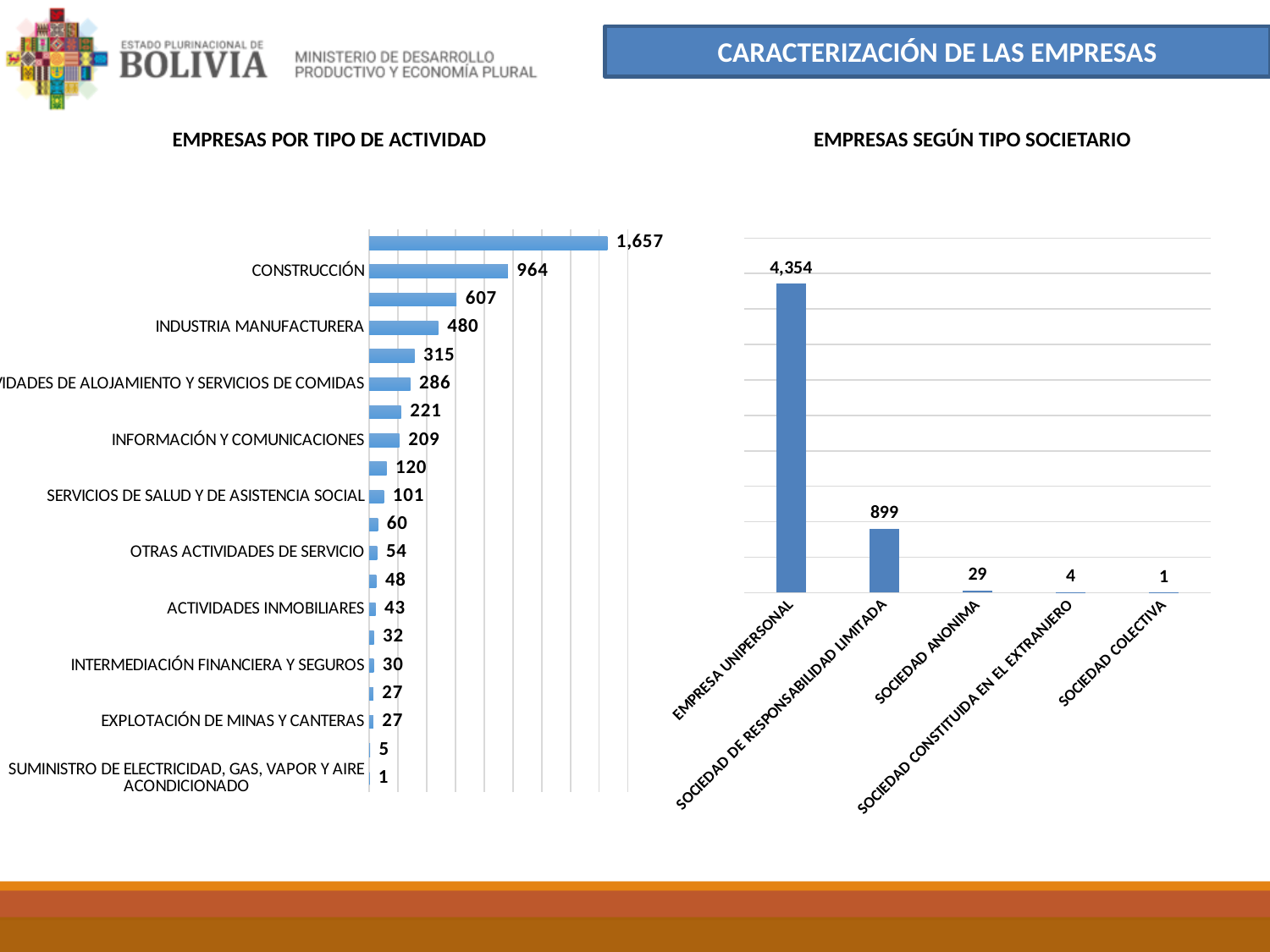
In the chart 'EMPRESAS SEGÚN TIPO SOCIETARIO', what is the value for SOCIEDAD DE RESPONSABILIDAD LIMITADA? 899 What kind of chart is 'EMPRESAS POR TIPO DE ACTIVIDAD'? Bar chart In the chart 'EMPRESAS POR TIPO DE ACTIVIDAD', which is larger: INFORMACIÓN Y COMUNICACIONES or ACTIVIDADES INMOBILIARIAS? INFORMACIÓN Y COMUNICACIONES In the chart 'EMPRESAS SEGÚN TIPO SOCIETARIO', what is the value for SOCIEDAD ANONIMA? 29 In the chart 'EMPRESAS POR TIPO DE ACTIVIDAD', what is the value for INDUSTRIA MANUFACTURERA? 480 In the chart 'EMPRESAS POR TIPO DE ACTIVIDAD', what is the value for SERVICIOS DE SALUD Y DE ASISTENCIA SOCIAL? 101 In the chart 'EMPRESAS SEGÚN TIPO SOCIETARIO', what is the value for EMPRESA UNIPERSONAL? 4,354 In the chart 'EMPRESAS POR TIPO DE ACTIVIDAD', what is the difference between CONSTRUCCIÓN and INDUSTRIA MANUFACTURERA? 484 In the chart 'EMPRESAS SEGÚN TIPO SOCIETARIO', which category has the lowest value? SOCIEDAD COLECTIVA In the chart 'EMPRESAS SEGÚN TIPO SOCIETARIO', what is the difference between EMPRESA UNIPERSONAL and SOCIEDAD DE RESPONSABILIDAD LIMITADA? 3,455 In the chart 'EMPRESAS SEGÚN TIPO SOCIETARIO', how many categories are shown? 5 In the chart 'EMPRESAS POR TIPO DE ACTIVIDAD', what is the value for CONSTRUCCIÓN? 964